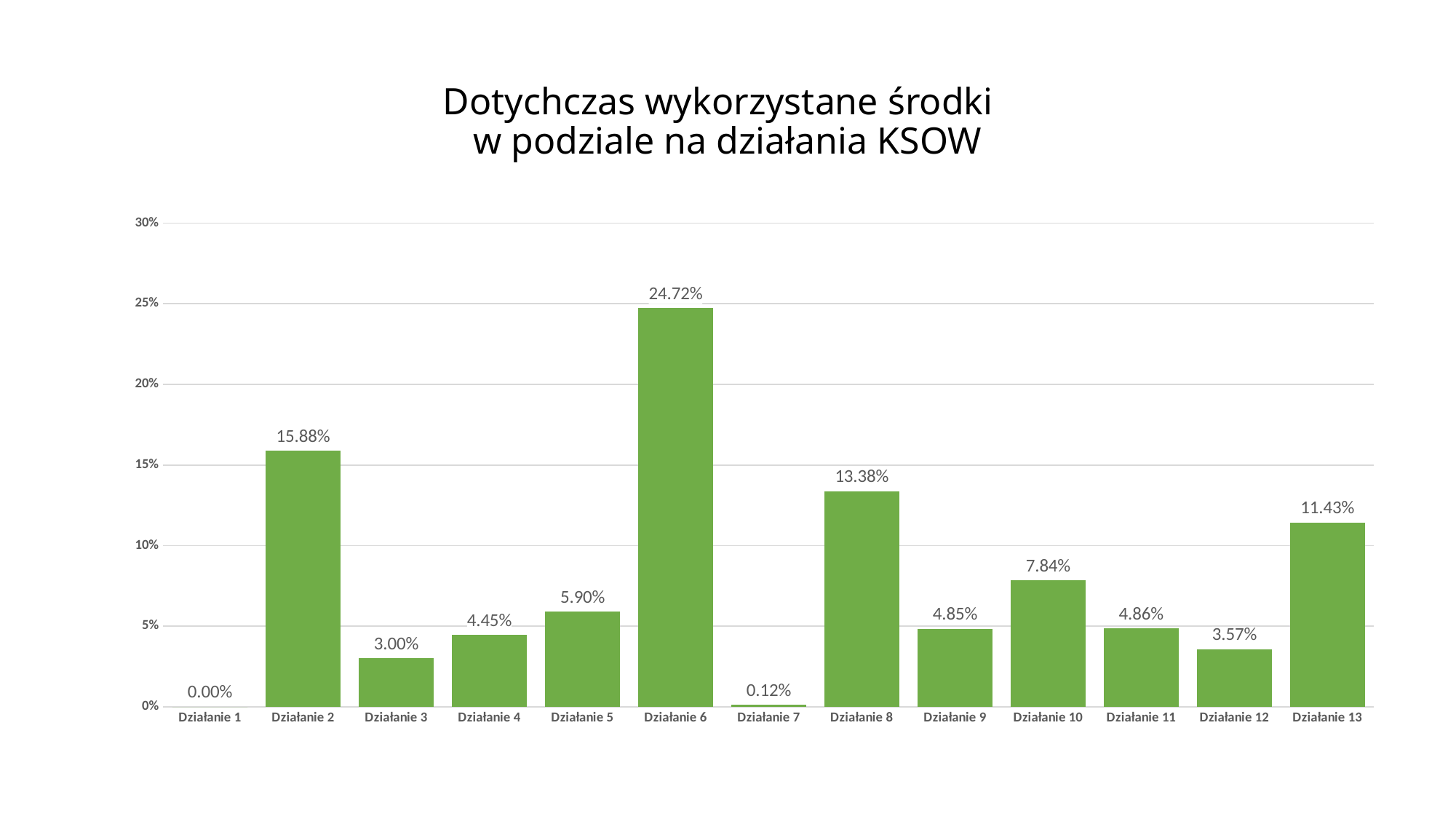
Is the value for Działanie 8 greater or less than 10%? greater What kind of chart is shown on the slide? bar chart What is the value for Działanie 7? 0.12% Which category has the highest value? Działanie 6 Which category has the lowest value? Działanie 1 What is the value for Działanie 2? 15.88% Which is larger, the value for Działanie 10 or the value for Działanie 5? Działanie 10 How many categories are shown on the x axis? 13 What is the value for Działanie 13? 11.43% What is the difference between the values for Działanie 6 and Działanie 8? 11.34% What is the title of the chart? Dotychczas wykorzystane środki w podziale na działania KSOW What is the value for Działanie 6? 24.72%